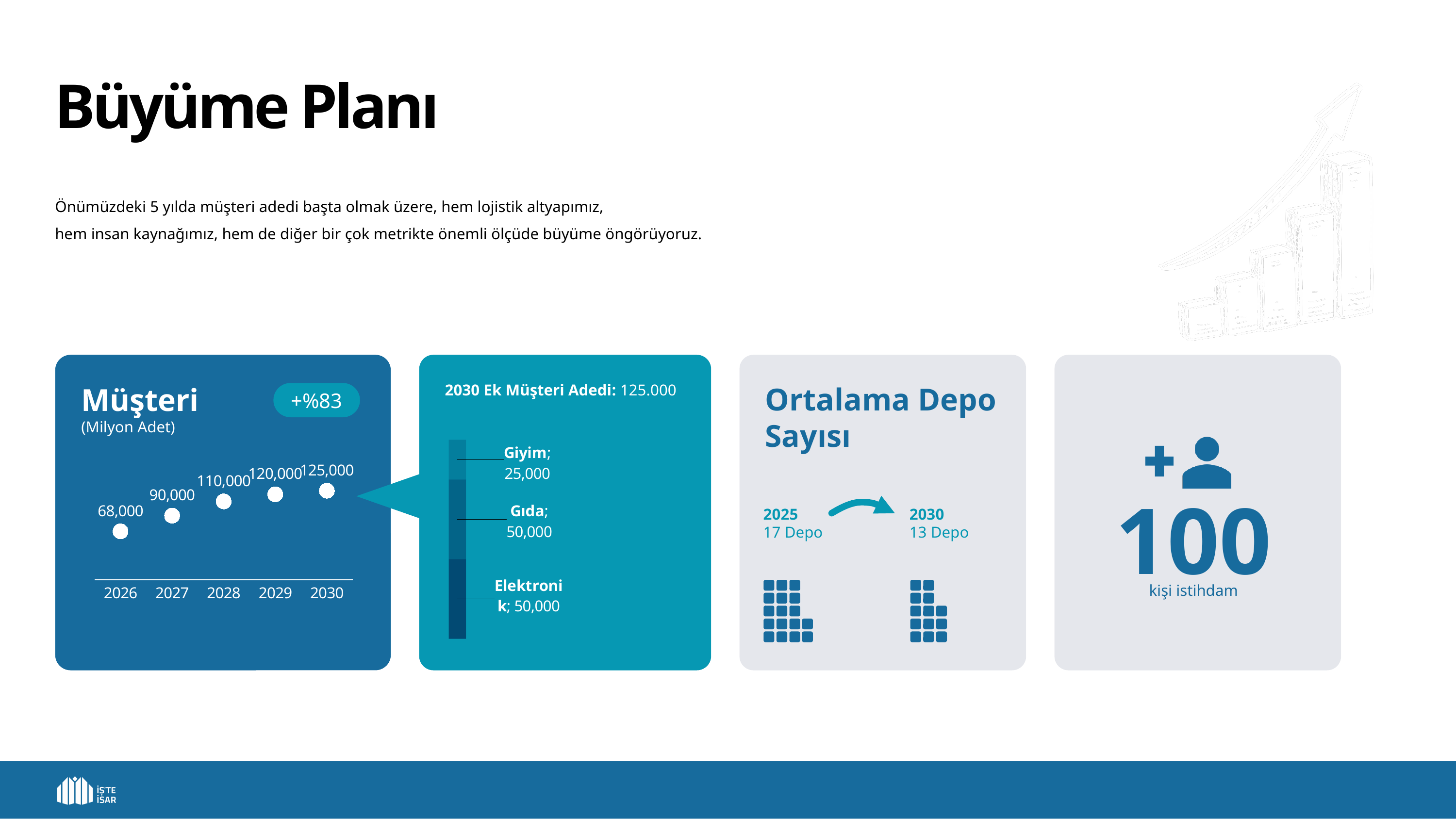
In the 2030 Ek Müşteri Adedi chart, how many segments make up the stacked bar? 3 In the Müşteri (Milyon Adet) chart, which year has the highest value? 2030 In the Müşteri (Milyon Adet) chart, what is the difference between the 2030 value and the 2026 value? 57,000 In the 2030 Ek Müşteri Adedi chart, what is the value for Gıda? 50,000 In the Müşteri (Milyon Adet) chart, what is the value for 2028? 110,000 In the 2030 Ek Müşteri Adedi chart, what is the value for Giyim? 25,000 In the 2030 Ek Müşteri Adedi chart, what is the total of the stacked bar? 125,000 In the Müşteri (Milyon Adet) chart, what is the value for 2026? 68,000 In the Müşteri (Milyon Adet) chart, which year has the lowest value? 2026 In the Müşteri (Milyon Adet) chart, how many years are plotted? 5 In the Müşteri (Milyon Adet) chart, do the values rise or fall from 2026 to 2030? rise In the 2030 Ek Müşteri Adedi chart, which is larger, Giyim or Elektronik? Elektronik